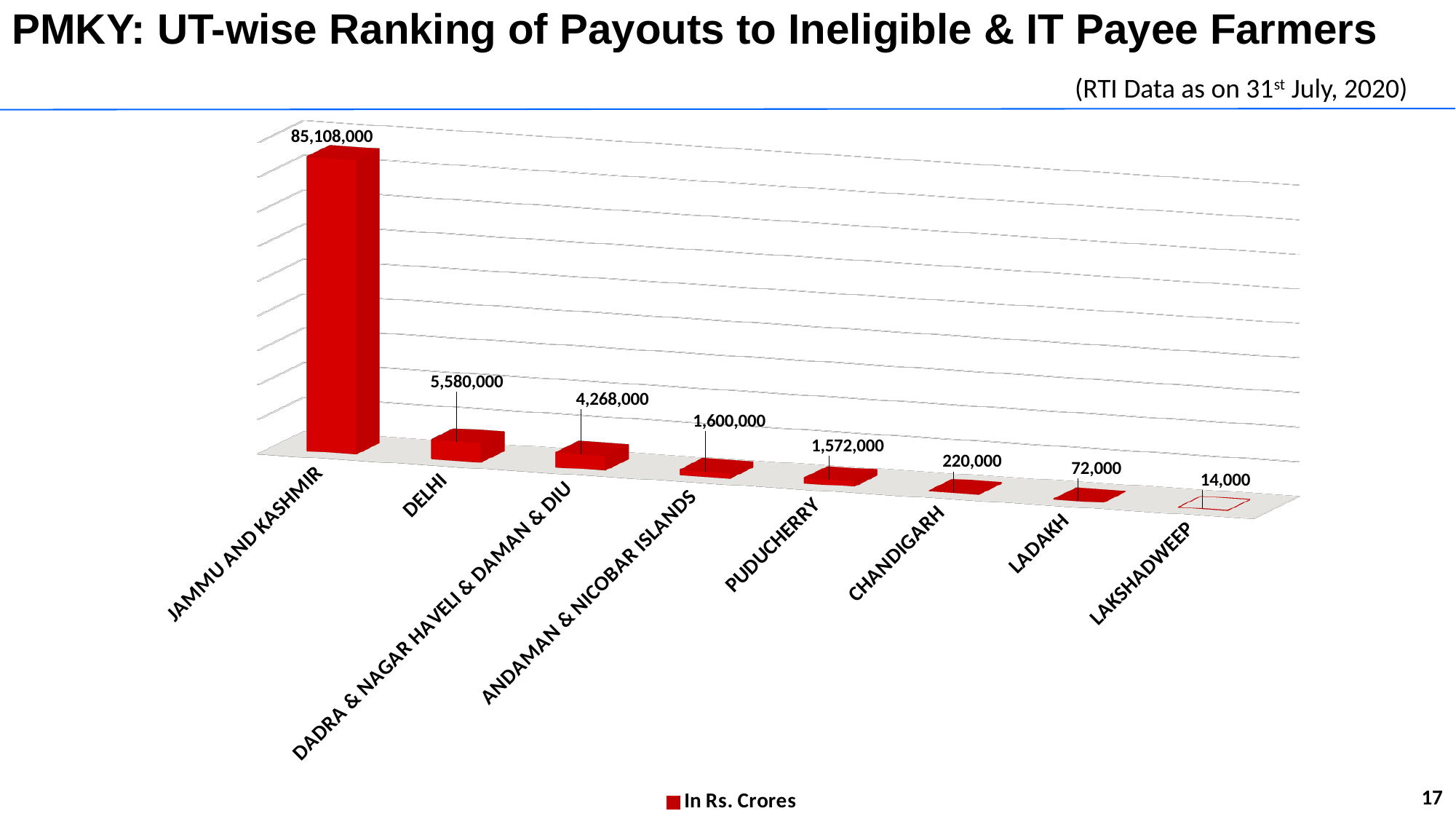
Which UT has the lowest value? Lakshadweep What is the difference between the values for Chandigarh and Ladakh? 148,000 What is the difference between the values for Delhi and Dadra & Nagar Haveli & Daman & Diu? 1,312,000 Which UT has the highest value? Jammu and Kashmir What kind of chart is shown on the slide? Bar chart What is the value for Puducherry? 1,572,000 Which is larger, the value for Andaman & Nicobar Islands or the value for Puducherry? Andaman & Nicobar Islands What is the value for Lakshadweep? 14,000 What is the value for Jammu and Kashmir? 85,108,000 How many UTs are shown on the chart? 8 What is the value for Delhi? 5,580,000 What is the legend entry shown below the chart? In Rs. Crores